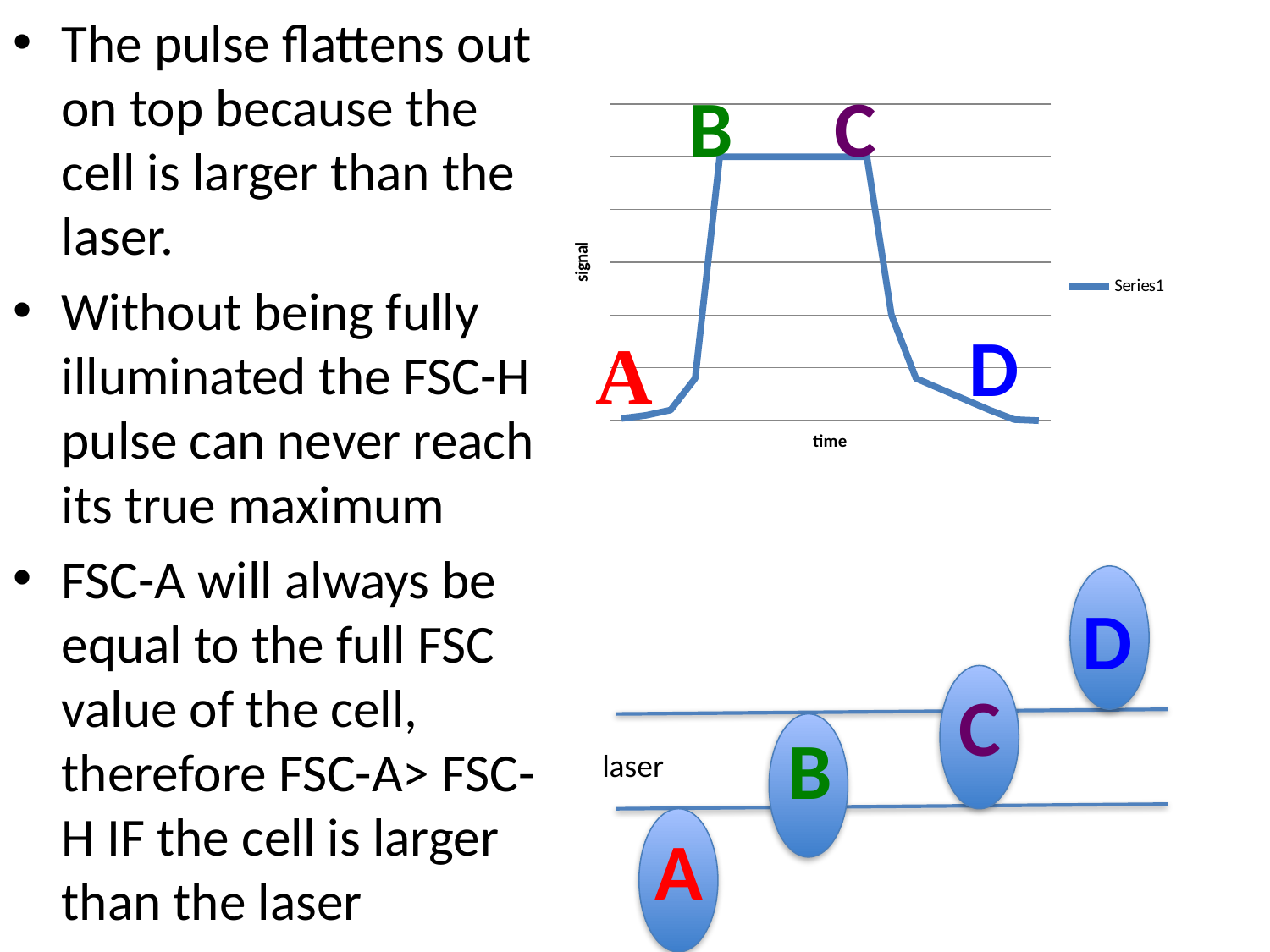
Which has the higher signal value, point A or point B? B What is the name of the series shown in the chart legend? Series1 Which has the higher signal value, point C or point D? C What is the label on the vertical axis of the chart? signal Does the signal rise or fall between point C and point D? fall What kind of chart is shown on the slide? line chart Does the signal rise or fall between point A and point B? rise Which has the lower signal value, point D or point B? D How many series does the chart legend list? 1